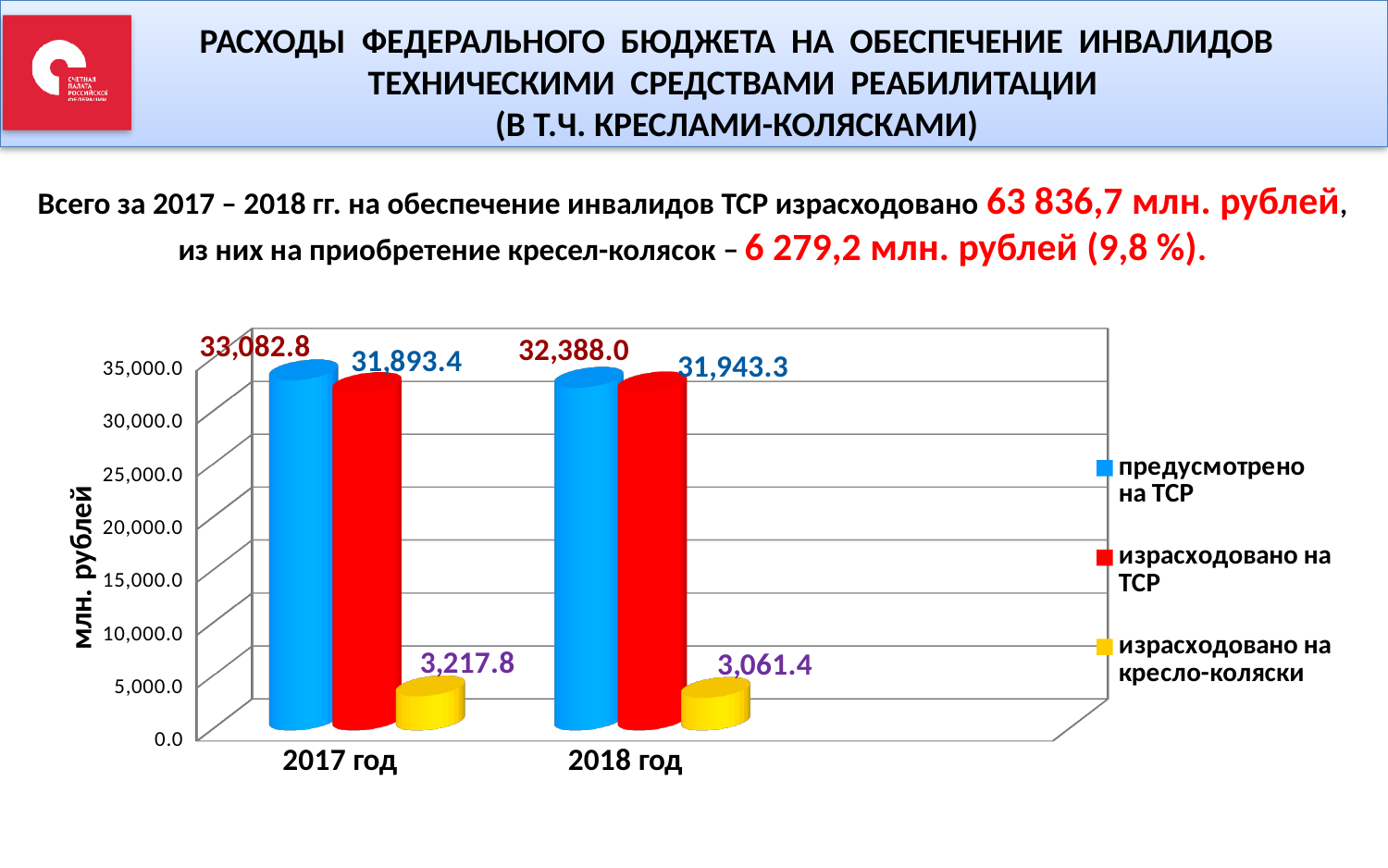
What is the difference between «израсходовано на кресло-коляски» in 2017 год and 2018 год? 156.4 What is the value of «израсходовано на кресло-коляски» for 2018 год? 3,061.4 Is «израсходовано на ТСР» larger in 2017 год or in 2018 год? 2018 год What is the difference between «предусмотрено на ТСР» and «израсходовано на ТСР» in 2017 год? 1,189.4 Which year has the higher value for «предусмотрено на ТСР»? 2017 год How many series does the legend list? 3 What is the value of «предусмотрено на ТСР» for 2017 год? 33,082.8 What kind of chart is shown on the slide? bar chart Which series has the lowest value in 2018 год? израсходовано на кресло-коляски What is the value of «израсходовано на кресло-коляски» for 2017 год? 3,217.8 What is the value of «израсходовано на ТСР» for 2018 год? 31,943.3 What is the label of the vertical axis? млн. рублей